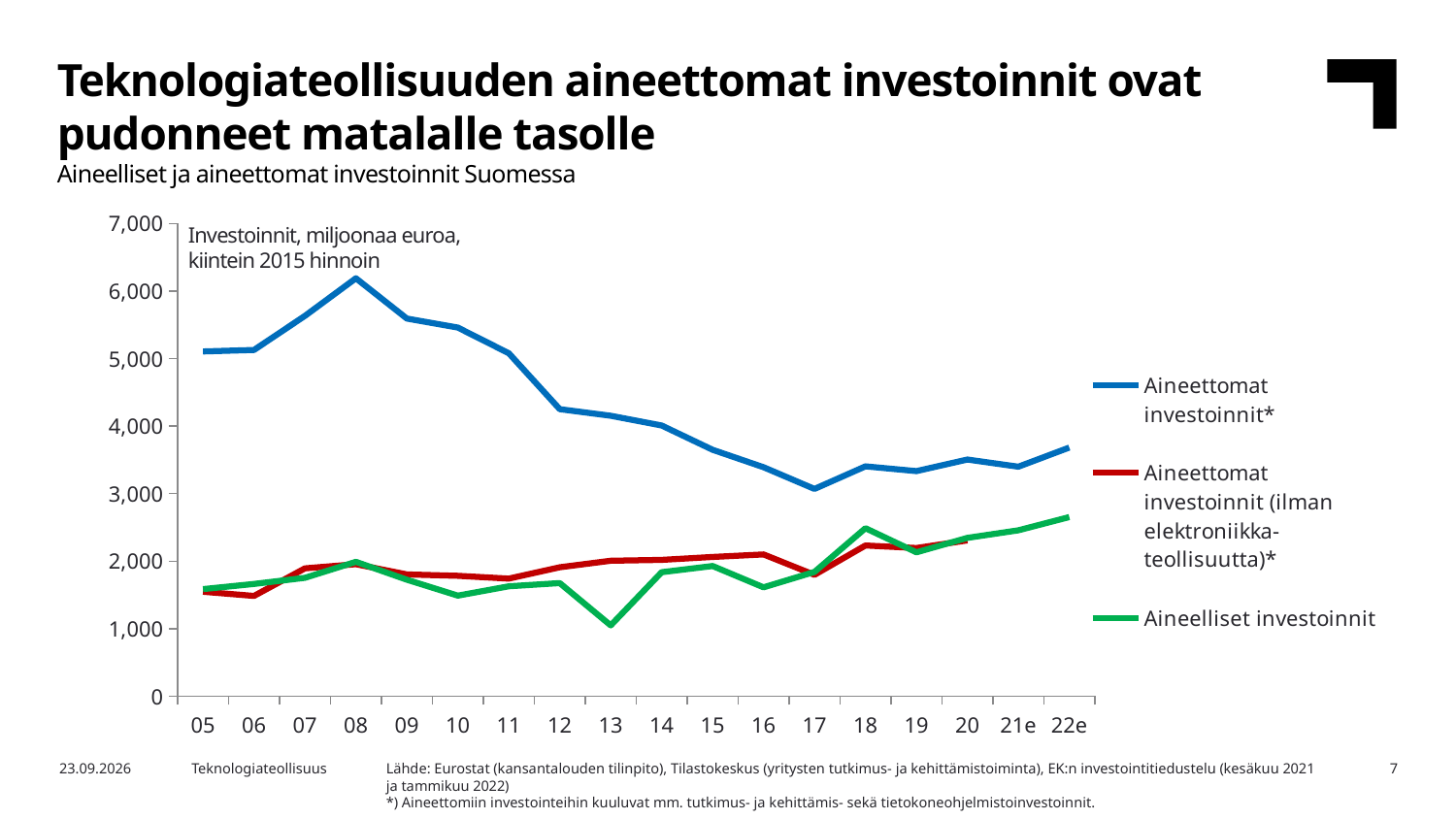
Is the value for Aineelliset investoinnit in 18 greater or less than 2,000? greater What kind of chart is shown on the slide? line chart In which year does the Aineettomat investoinnit* series reach its highest value? 08 Which colour is used for the Aineelliset investoinnit series? green Which series has the larger value in 08, Aineettomat investoinnit* or Aineelliset investoinnit? Aineettomat investoinnit* Is the value for Aineettomat investoinnit* in 22e greater or less than 4,000? less How many years are shown on the x axis? 18 How many series does the legend list? 3 In which year does the Aineelliset investoinnit series reach its lowest value? 13 Is the value for Aineettomat investoinnit (ilman elektroniikkateollisuutta)* in 05 greater or less than 2,000? less Does the Aineettomat investoinnit* series rise or fall between 08 and 17? fall